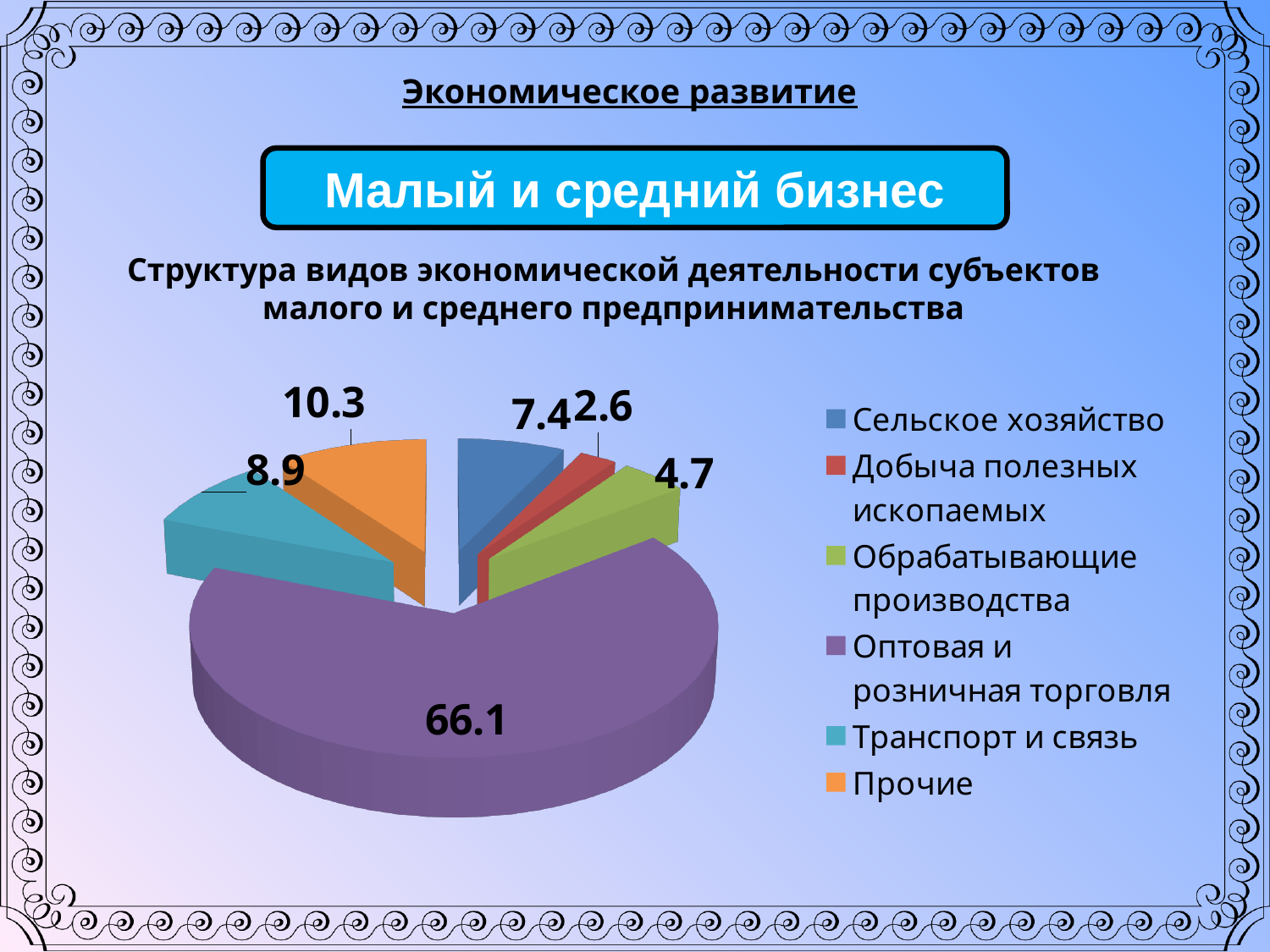
Which is larger, the value for Обрабатывающие производства or the value for Сельское хозяйство? Сельское хозяйство Which category has the smallest slice of the pie? Добыча полезных ископаемых What is the difference between the values for Оптовая и розничная торговля and Прочие? 55.8 What is the value for Добыча полезных ископаемых? 2.6 Which category has the largest slice of the pie? Оптовая и розничная торговля How many categories does the pie chart have? 6 What is the value for Транспорт и связь? 8.9 What type of chart is shown on the slide? Pie chart What colour is the slice for Прочие? Orange What is the value for Сельское хозяйство? 7.4 What is the value for Оптовая и розничная торговля? 66.1 What is the difference between the values for Прочие and Транспорт и связь? 1.4